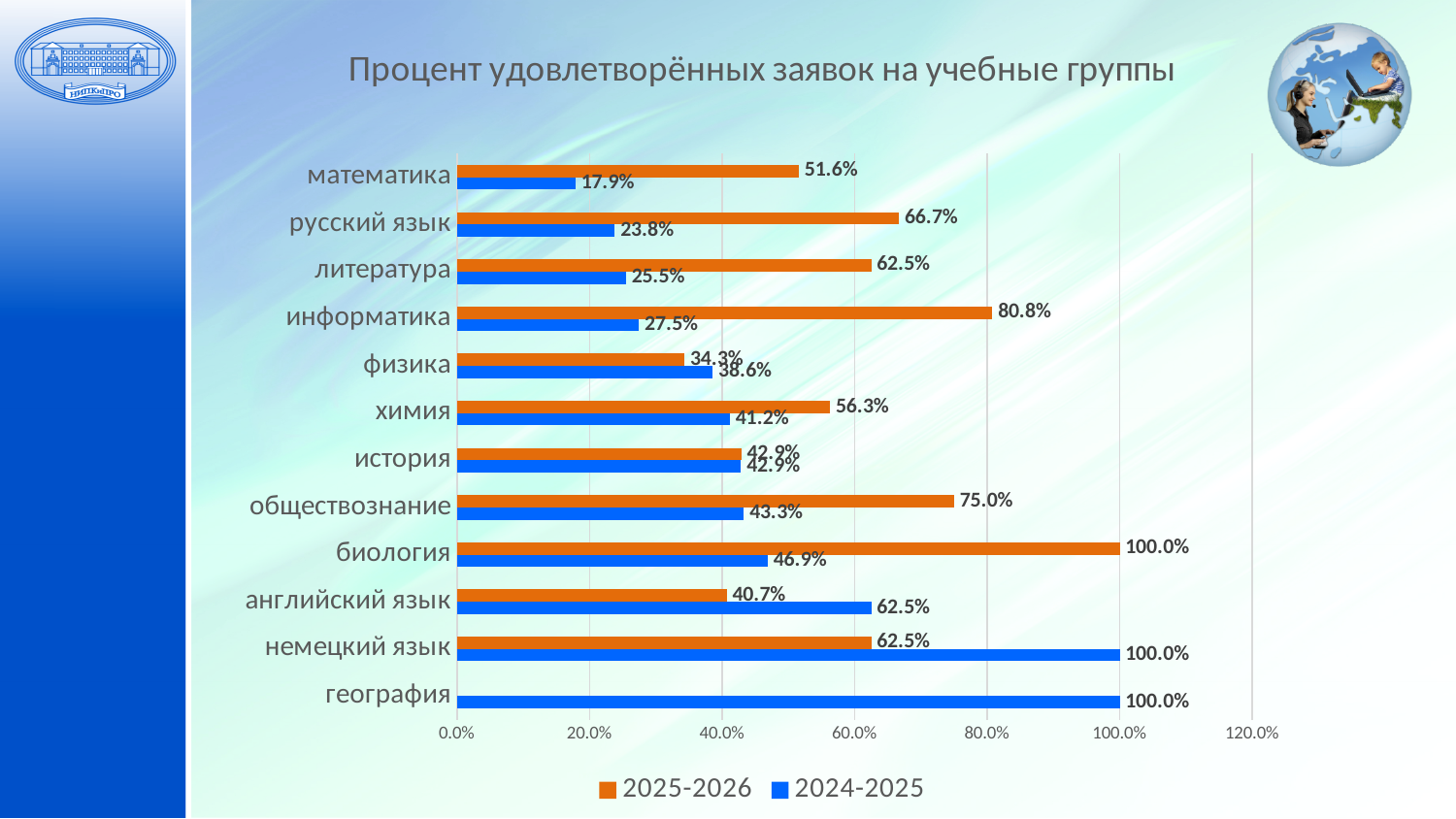
What is the value for английский язык in the 2024-2025 series? 62.5% What is the value for информатика in the 2025-2026 series? 80.8% What is the value for математика in the 2024-2025 series? 17.9% For физика, which series has the larger value, 2025-2026 or 2024-2025? 2024-2025 Which category has the highest value in the 2025-2026 series? биология What is the difference between the 2025-2026 and 2024-2025 values for русский язык? 42.9% Which category has the lowest value in the 2024-2025 series? математика What is the difference between the 2024-2025 and 2025-2026 values for немецкий язык? 37.5% What kind of chart is shown on the slide? bar chart How many categories are shown on the chart? 12 How many series does the legend list? 2 What is the title of the chart? Процент удовлетворённых заявок на учебные группы